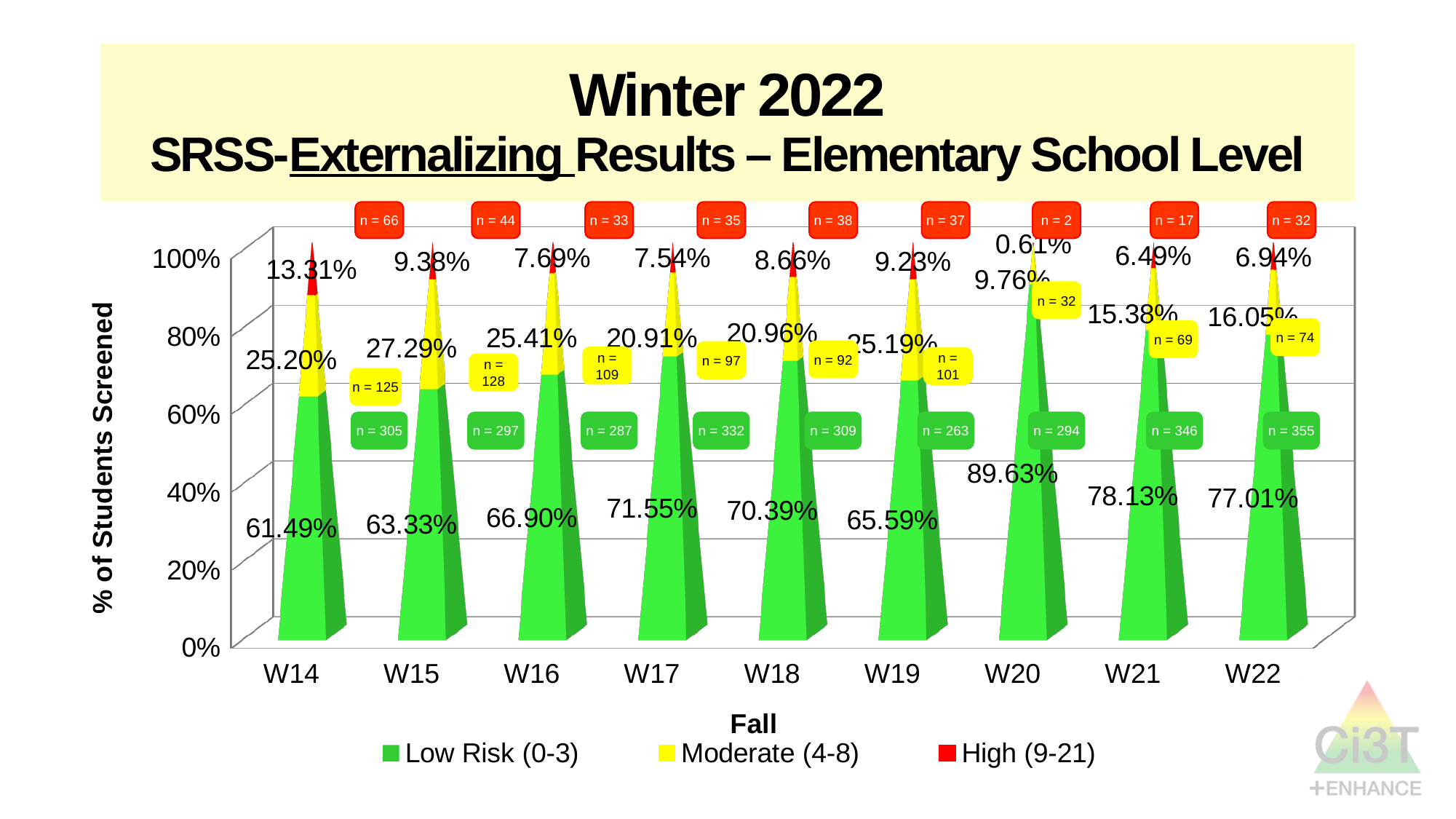
What is the Low Risk (0-3) percentage for W20? 89.63% What kind of chart is shown on the slide? Stacked bar chart How many schools are shown on the x axis? 9 What is the difference between the Low Risk (0-3) percentages for W21 and W22? 1.12% What is the High (9-21) percentage for W14? 13.31% What is the Moderate (4-8) percentage for W15? 27.29% How many series does the legend list? 3 Which school has the lowest High (9-21) percentage? W20 Which school has the highest Low Risk (0-3) percentage? W20 What is the title of the y axis? % of Students Screened Which school has the lowest Low Risk (0-3) percentage? W14 Which has a larger Low Risk (0-3) percentage, W17 or W18? W17